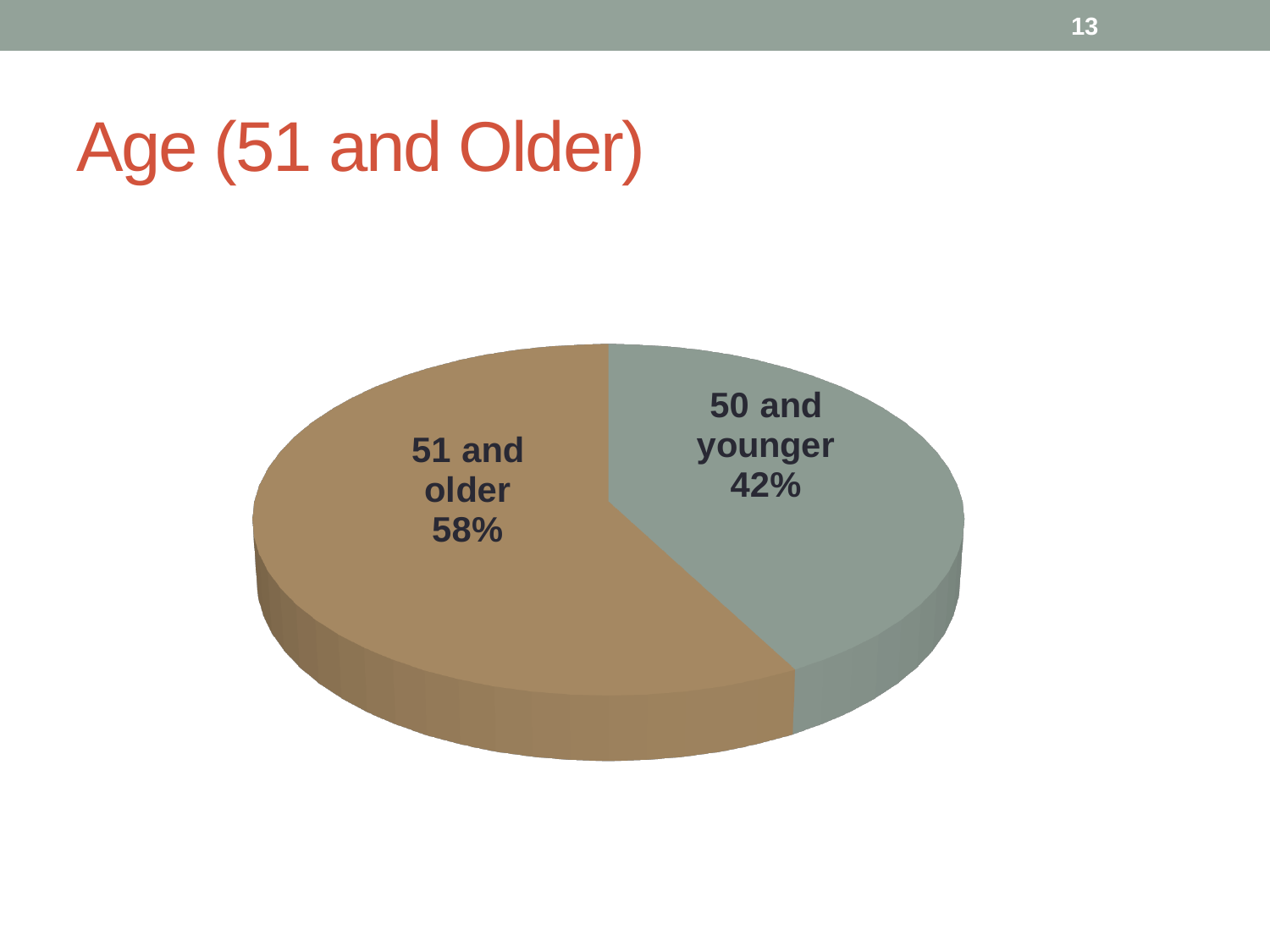
What is the difference in percentage points between the '51 and older' slice and the '50 and younger' slice? 16 What percentage of the pie is the '50 and younger' slice? 42% What colour is the '51 and older' slice? Brown What percentage of the pie is the '51 and older' slice? 58% What kind of chart is shown on the slide? Pie chart What share of the pie does the '50 and younger' slice represent? 42% Which is larger, the '51 and older' slice or the '50 and younger' slice? 51 and older Which slice of the pie is the smallest? 50 and younger How many slices does the pie chart have? 2 Which slice of the pie is the largest? 51 and older What is the title of the slide containing the chart? Age (51 and Older)